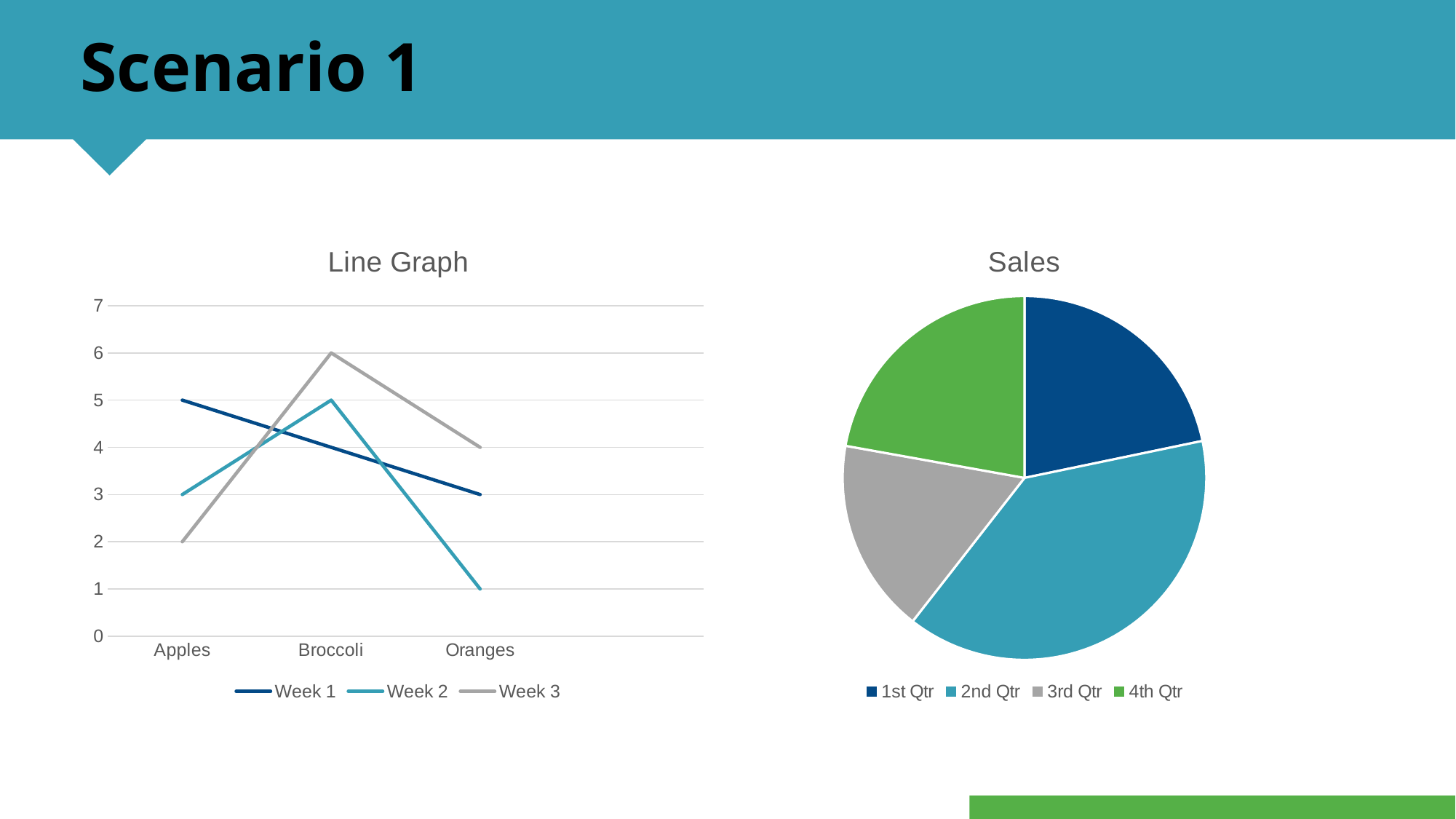
In the Sales pie chart, which quarter has the largest slice? 2nd Qtr In the Line Graph chart, what is the value for Week 1 at Apples? 5 In the Line Graph chart, what is the difference between the Week 3 value at Broccoli and the Week 3 value at Apples? 4 In the Line Graph chart, which is larger at Oranges: Week 1 or Week 3? Week 3 In the Line Graph chart, what is the value for Week 3 at Broccoli? 6 How many series does the legend of the Line Graph chart list? 3 In the Line Graph chart, which category has the highest value for Week 3? Broccoli In the Line Graph chart, what is the value for Week 2 at Oranges? 1 What kind of chart is the Sales chart? pie chart In the Line Graph chart, do the Week 1 values rise or fall from Apples to Oranges? fall How many slices does the Sales pie chart have? 4 In the Line Graph chart, which category has the lowest value for Week 2? Oranges